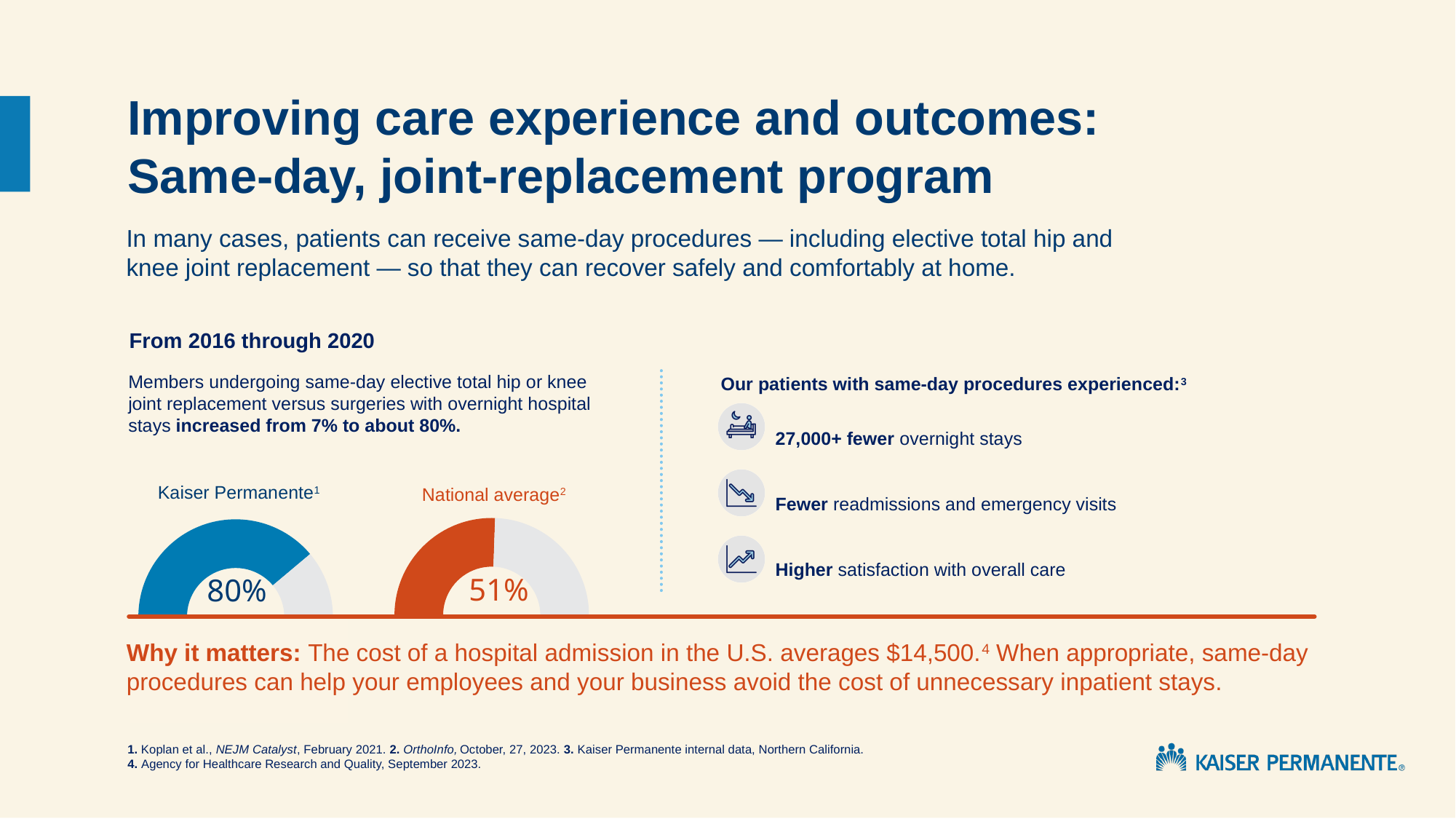
What value is shown on the National average gauge chart? 51% What value is shown on the Kaiser Permanente gauge chart? 80% Which of the two gauge charts shows the higher value, Kaiser Permanente or National average? Kaiser Permanente What is the difference between the Kaiser Permanente value and the National average value shown on the gauge charts? 29 percentage points What colour is the filled portion of the National average gauge chart? Orange-red Which gauge chart shows the lowest value? National average How many gauge charts are shown on the slide? 2 What kind of chart is used to show the Kaiser Permanente and National average percentages? Semicircular gauge (half-donut) chart Is the value on the National average gauge chart greater or less than 50%? greater What colour is the filled portion of the Kaiser Permanente gauge chart? Blue